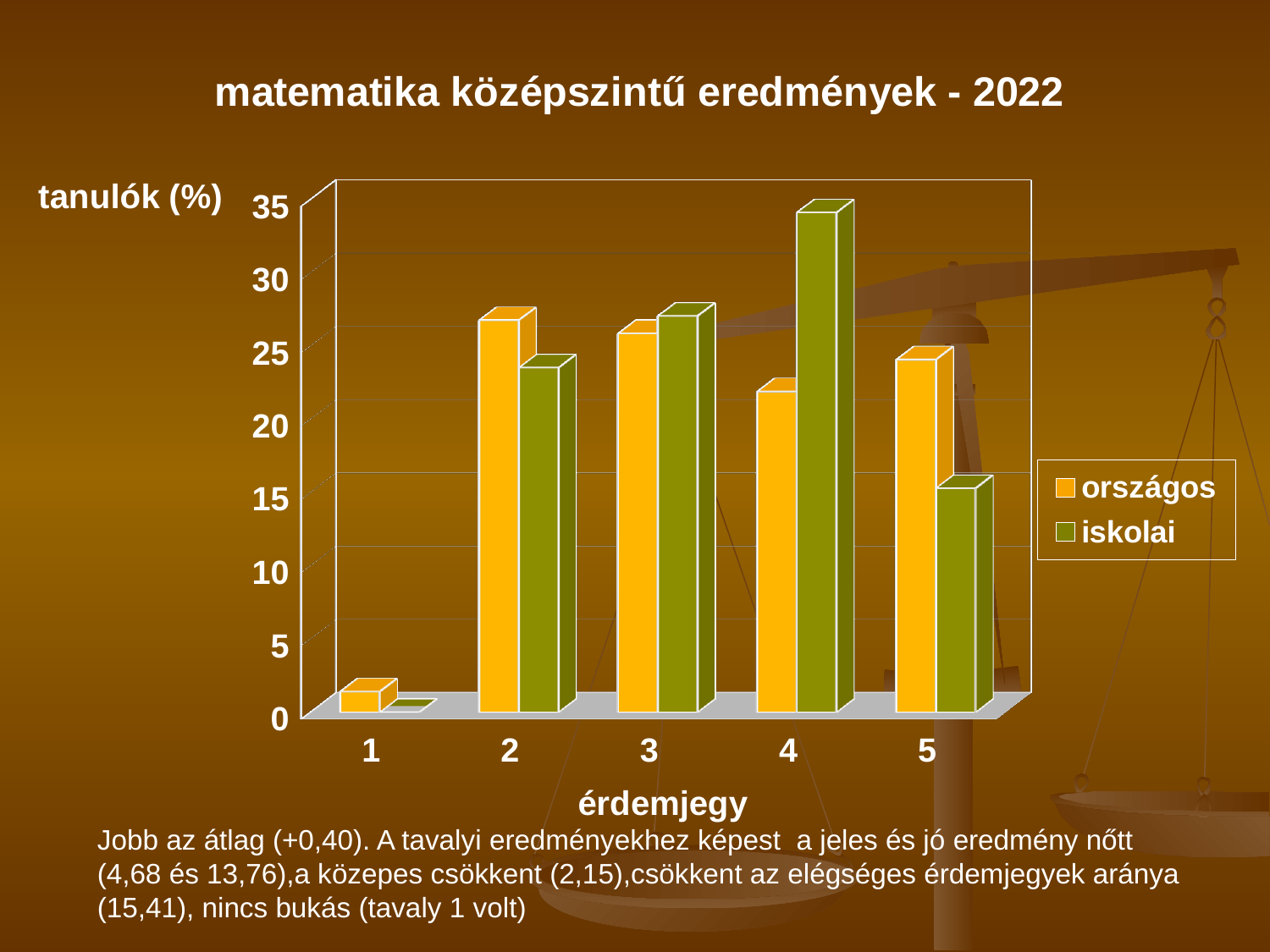
For which érdemjegy is the iskolai value highest? 4 For érdemjegy 5, which series has the larger value, országos or iskolai? országos What kind of chart is shown on the slide? bar chart What is the title of the chart? matematika középszintű eredmények - 2022 Is the iskolai value for érdemjegy 4 greater or less than 30? greater For érdemjegy 4, which series has the larger value, országos or iskolai? iskolai Is the iskolai value for érdemjegy 5 greater or less than 20? less Is the országos value for érdemjegy 1 greater or less than 5? less How many series does the legend list? 2 How many categories (érdemjegy values) are shown on the x axis? 5 For which érdemjegy is the iskolai value lowest? 1 For which érdemjegy is the országos value lowest? 1